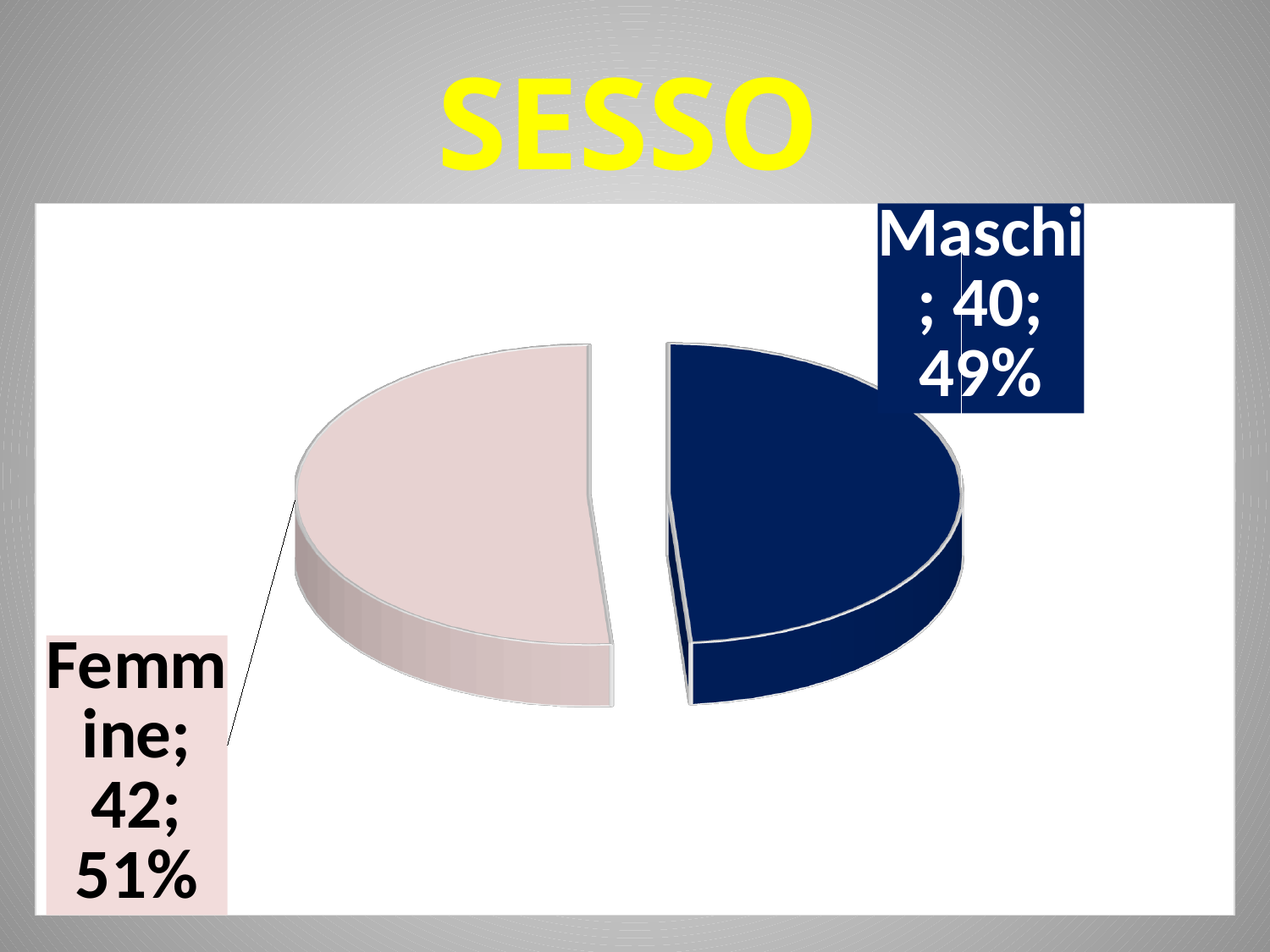
What is the value for Femmine? 42 What colour is the Maschi slice? dark blue What is the title of the chart? SESSO What is the value for Maschi? 40 What is the difference between the values for Femmine and Maschi? 2 What kind of chart is shown on the slide? pie chart Which category has the larger value, Maschi or Femmine? Femmine What share of the pie does Maschi represent? 49% What is the total of the two slice values? 82 What share of the pie does Femmine represent? 51% How many slices does the pie chart have? 2